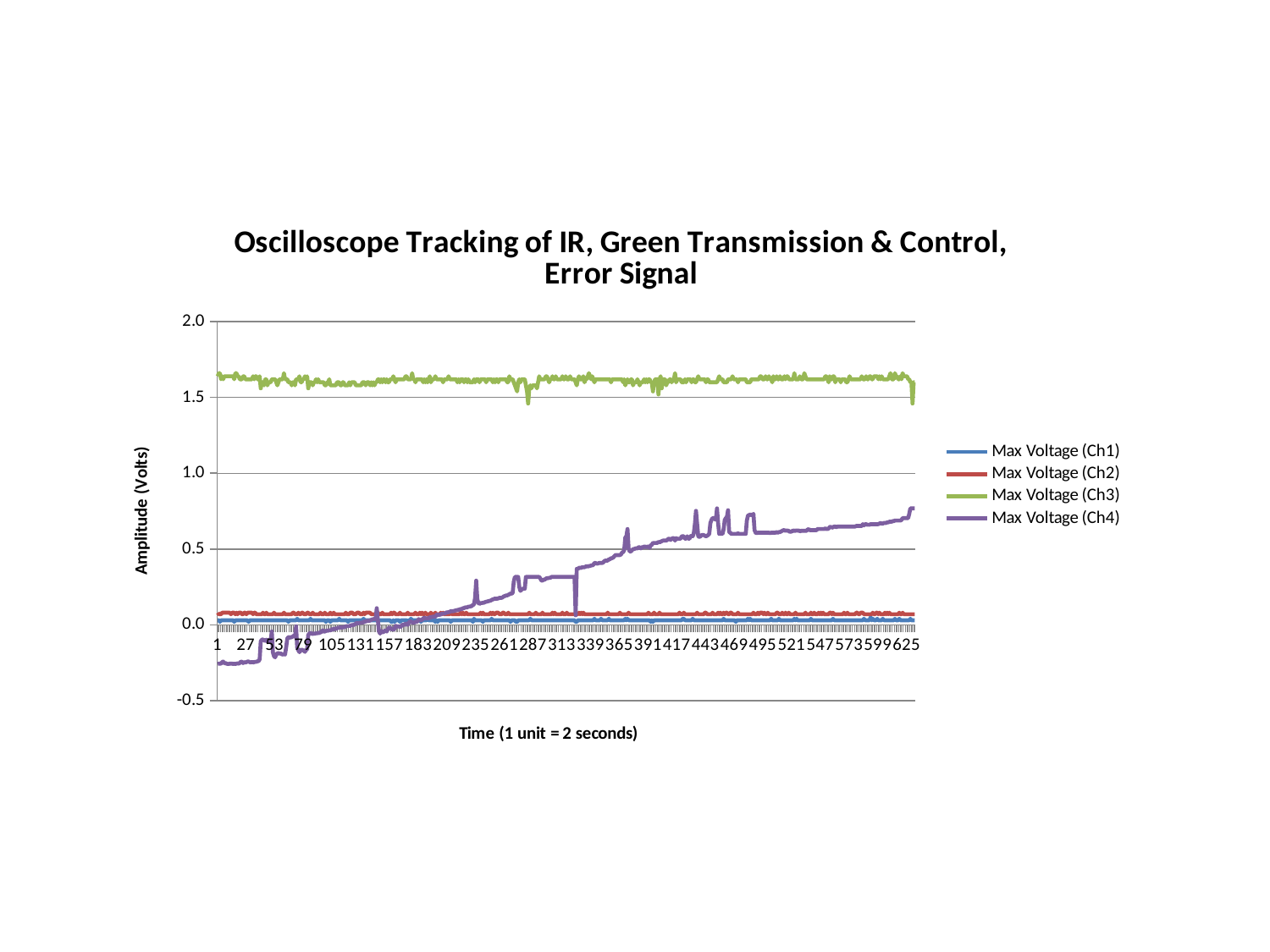
How many series does the legend list? 4 Is the value for Max Voltage (Ch4) at time 625 greater or less than 0.5? greater Is the value for Max Voltage (Ch4) at time 443 greater or less than 0.5? greater What kind of chart is shown on the slide? line chart Which series is higher, Max Voltage (Ch1) or Max Voltage (Ch2)? Max Voltage (Ch2) What is the label on the vertical axis? Amplitude (Volts) Is the value for Max Voltage (Ch4) at time 1 greater or less than 0.0? less Which series has the highest values across the whole time range? Max Voltage (Ch3) Does the Max Voltage (Ch4) series rise or fall along the x axis overall? rise What is the title of the chart? Oscilloscope Tracking of IR, Green Transmission & Control, Error Signal